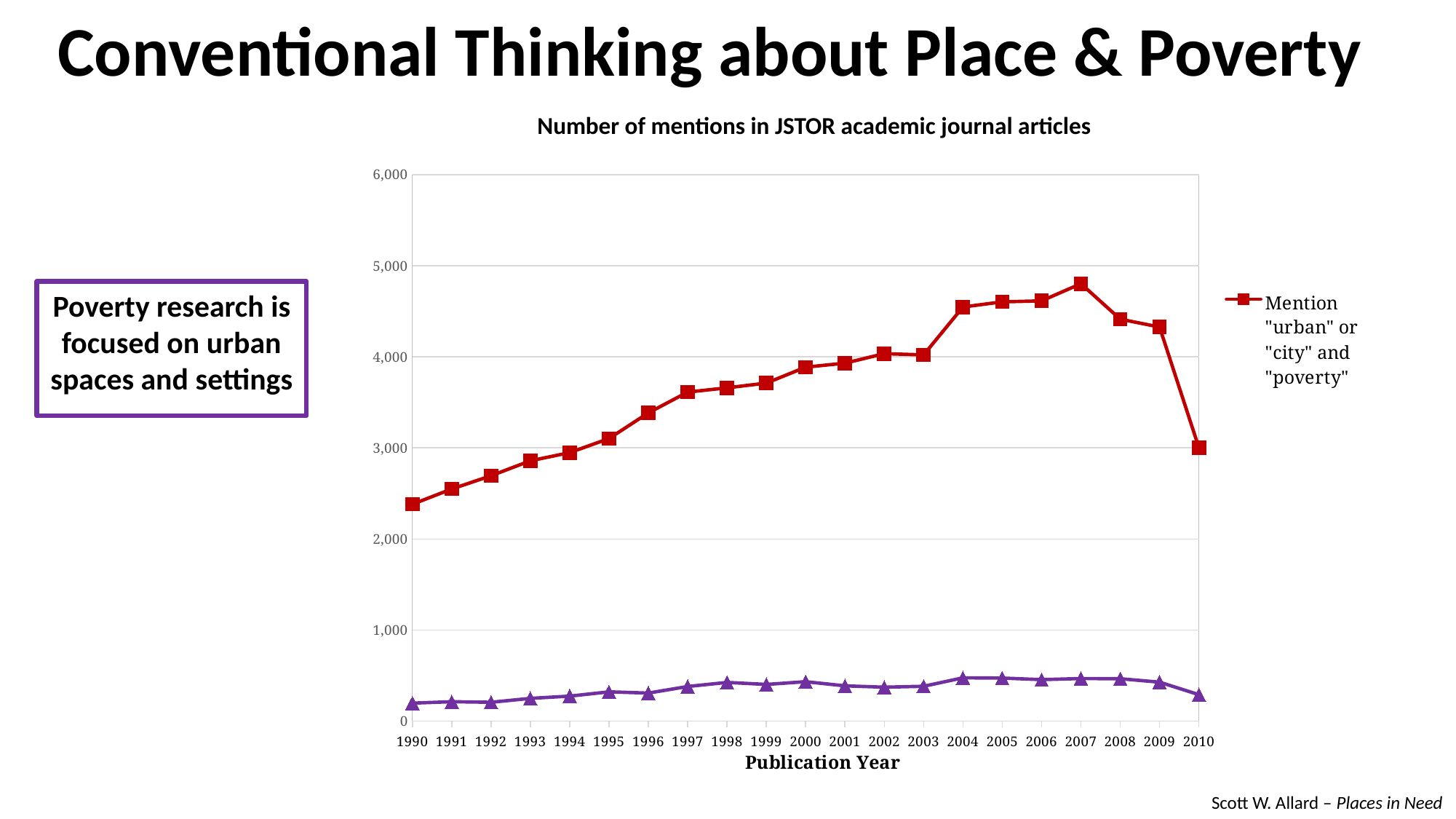
Does the red series rise or fall between 1990 and 2007? rise In which year is the red series (Mention "urban" or "city" and "poverty") at its lowest value? 1990 Is the value of the red series in 1990 greater or less than 3,000? less Which year has the larger value for the red series, 1996 or 2000? 2000 What is the title of the chart? Number of mentions in JSTOR academic journal articles What is the label of the x axis? Publication Year Which year has the larger value for the red series, 2007 or 2009? 2007 What kind of chart is shown on the slide? line chart In which year does the red series (Mention "urban" or "city" and "poverty") reach its highest value? 2007 Is the value of the purple series in 2005 greater or less than 1,000? less How many publication years are plotted along the x axis? 21 Is the value of the red series in 2007 greater or less than 4,000? greater